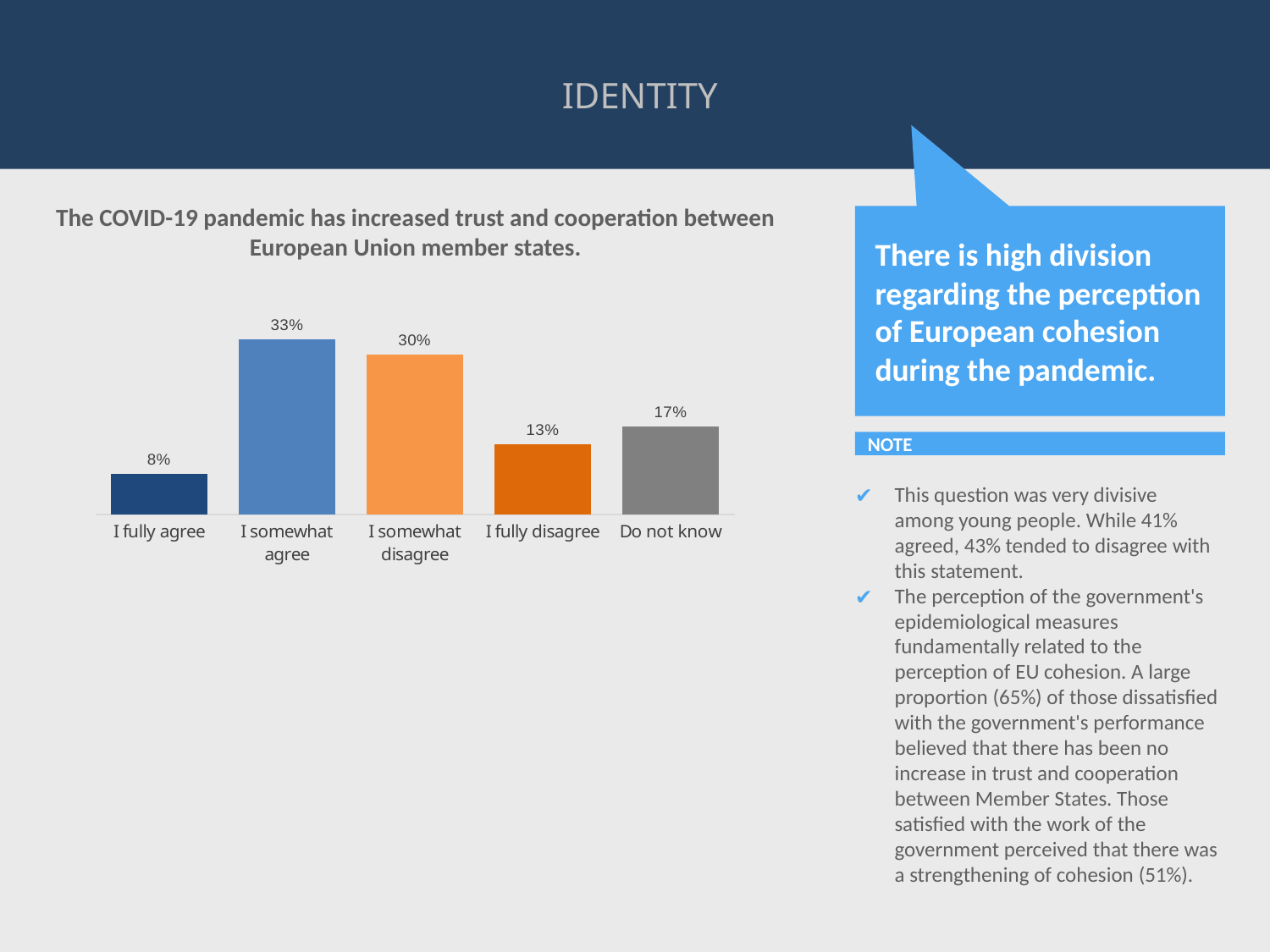
Which response category has the lowest percentage? I fully agree What is the combined percentage of "I fully agree" and "I somewhat agree"? 41% What statement is the chart title asking respondents about? The COVID-19 pandemic has increased trust and cooperation between European Union member states. How many response categories are shown on the chart? 5 What percentage of respondents answered "Do not know"? 17% What is the difference in percentage points between "Do not know" and "I fully disagree"? 4 What percentage of respondents chose "I somewhat disagree"? 30% What percentage of respondents chose "I fully agree"? 8% Which is larger, the value for "I fully disagree" or the value for "Do not know"? Do not know Which response category has the highest percentage? I somewhat agree What type of chart is shown on the slide? Bar chart What is the difference in percentage points between "I somewhat agree" and "I somewhat disagree"? 3